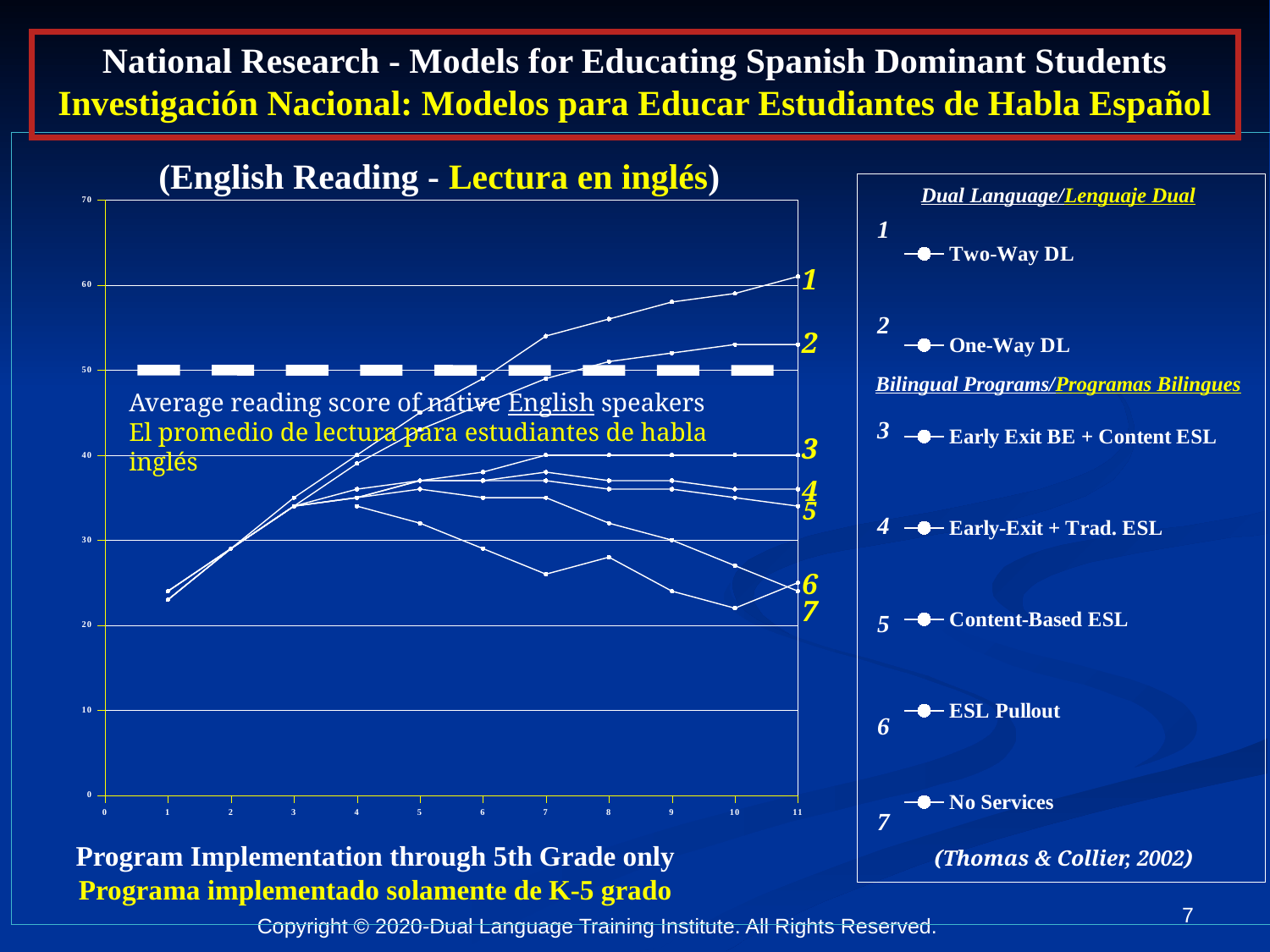
How many series does the legend list? 7 Is the value for Two-Way DL at grade 11 greater or less than 50? greater Is the value for Early Exit BE + Content ESL at grade 11 greater or less than 30? greater Is the value for One-Way DL at grade 11 greater or less than 50? greater Which legend entry is numbered 6? ESL Pullout Does the Two-Way DL line rise or fall from grade 1 to grade 11? rise At what value on the y axis is the dashed horizontal line for the average reading score of native English speakers drawn? 50 What kind of chart is shown on the slide? line chart At grade 11, which is higher: Two-Way DL or One-Way DL? Two-Way DL Which series has the lowest value at grade 10? No Services Which series has the highest value at grade 11? Two-Way DL